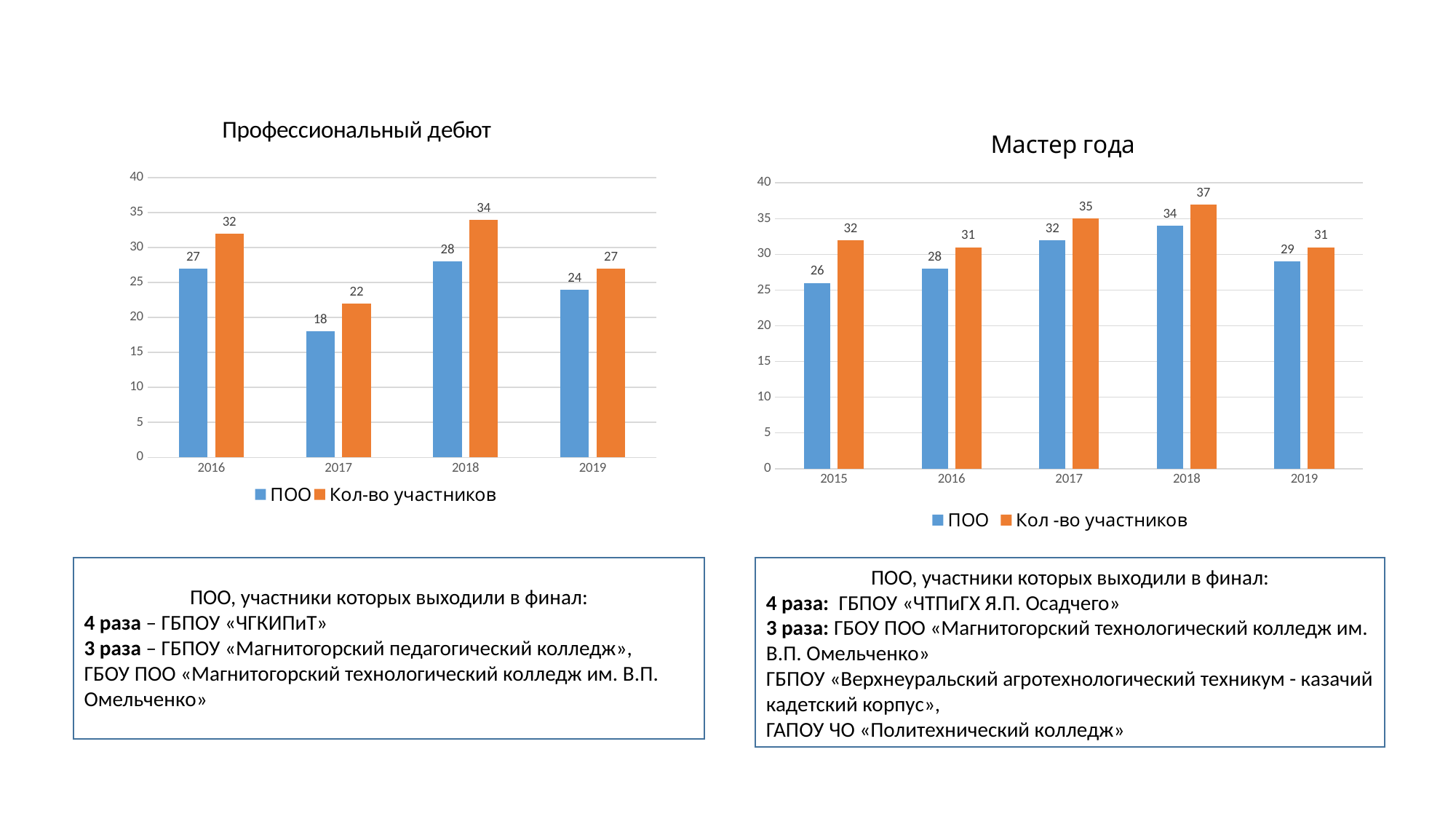
In the 'Мастер года' chart, what is the value of 'Кол -во участников' for 2018? 37 In the 'Профессиональный дебют' chart, which year has the lowest 'ПОО' value? 2017 In the 'Мастер года' chart, how many series does the legend list? 2 In the 'Профессиональный дебют' chart, what is the difference between 'Кол-во участников' and 'ПОО' in 2016? 5 What kind of chart is the 'Мастер года' chart? Bar chart In the 'Профессиональный дебют' chart, what is the value of 'Кол-во участников' for 2018? 34 In the 'Профессиональный дебют' chart, what is the value of 'ПОО' for 2017? 18 In the 'Мастер года' chart, what is the value of 'ПОО' for 2015? 26 In the 'Мастер года' chart, which year has the highest 'ПОО' value? 2018 In the 'Мастер года' chart, is the 'ПОО' value for 2019 larger or the 'ПОО' value for 2017? 2017 In the 'Профессиональный дебют' chart, how many years are shown on the x axis? 4 In the 'Мастер года' chart, what is the difference between 'Кол -во участников' in 2018 and 2019? 6